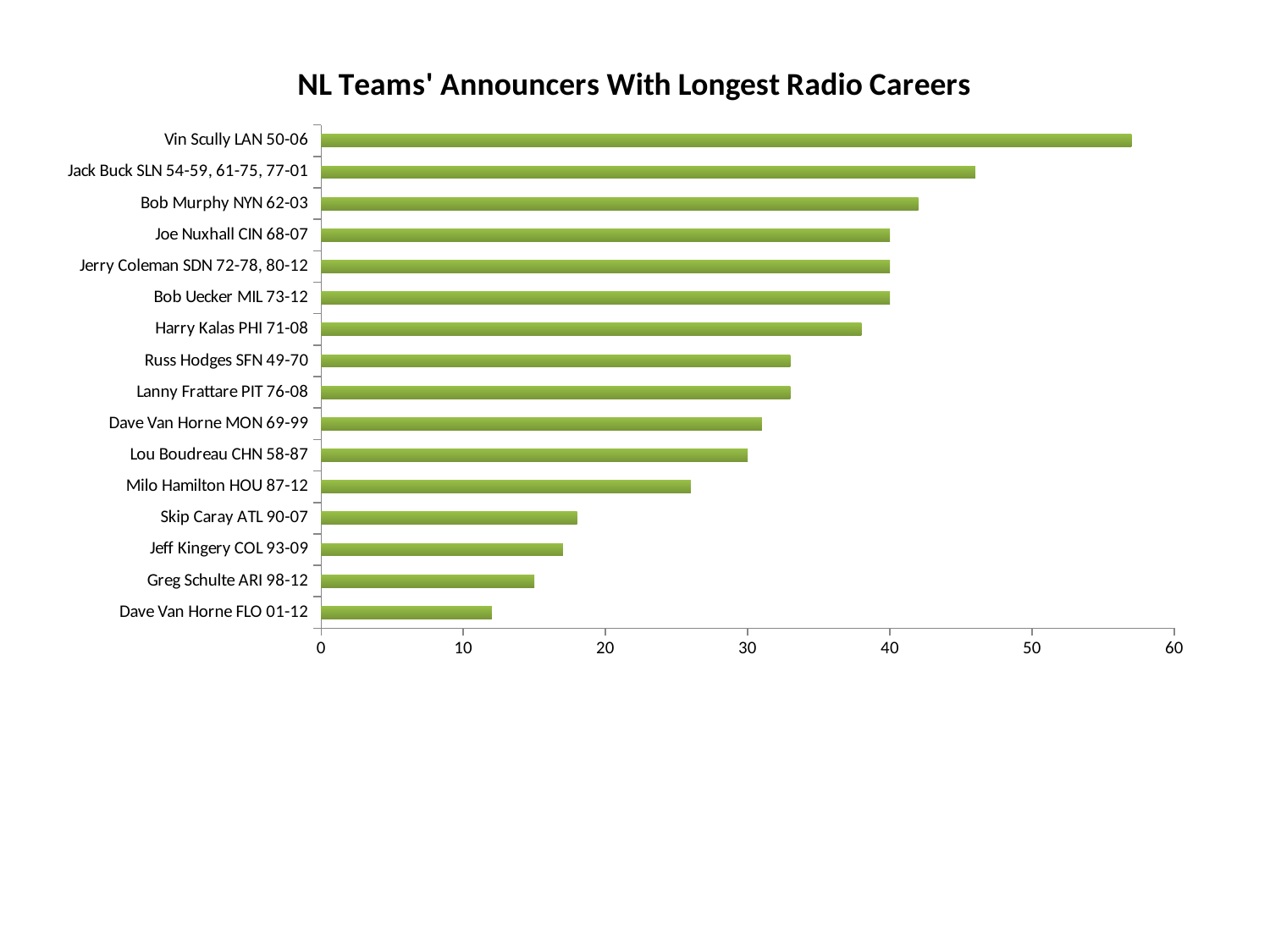
Is the value for Harry Kalas PHI 71-08 greater or less than 40? less Is the value for Vin Scully LAN 50-06 greater or less than 50? greater What is the title of the chart? NL Teams' Announcers With Longest Radio Careers Which announcer has the shortest radio career in the chart? Dave Van Horne FLO 01-12 Is the value for Skip Caray ATL 90-07 greater or less than 20? less Which is larger, the value for Greg Schulte ARI 98-12 or the value for Dave Van Horne FLO 01-12? Greg Schulte ARI 98-12 What kind of chart is shown on the slide? bar chart Which is larger, the value for Bob Murphy NYN 62-03 or the value for Harry Kalas PHI 71-08? Bob Murphy NYN 62-03 How many announcers are listed in the chart? 16 Which announcer has the longest radio career in the chart? Vin Scully LAN 50-06